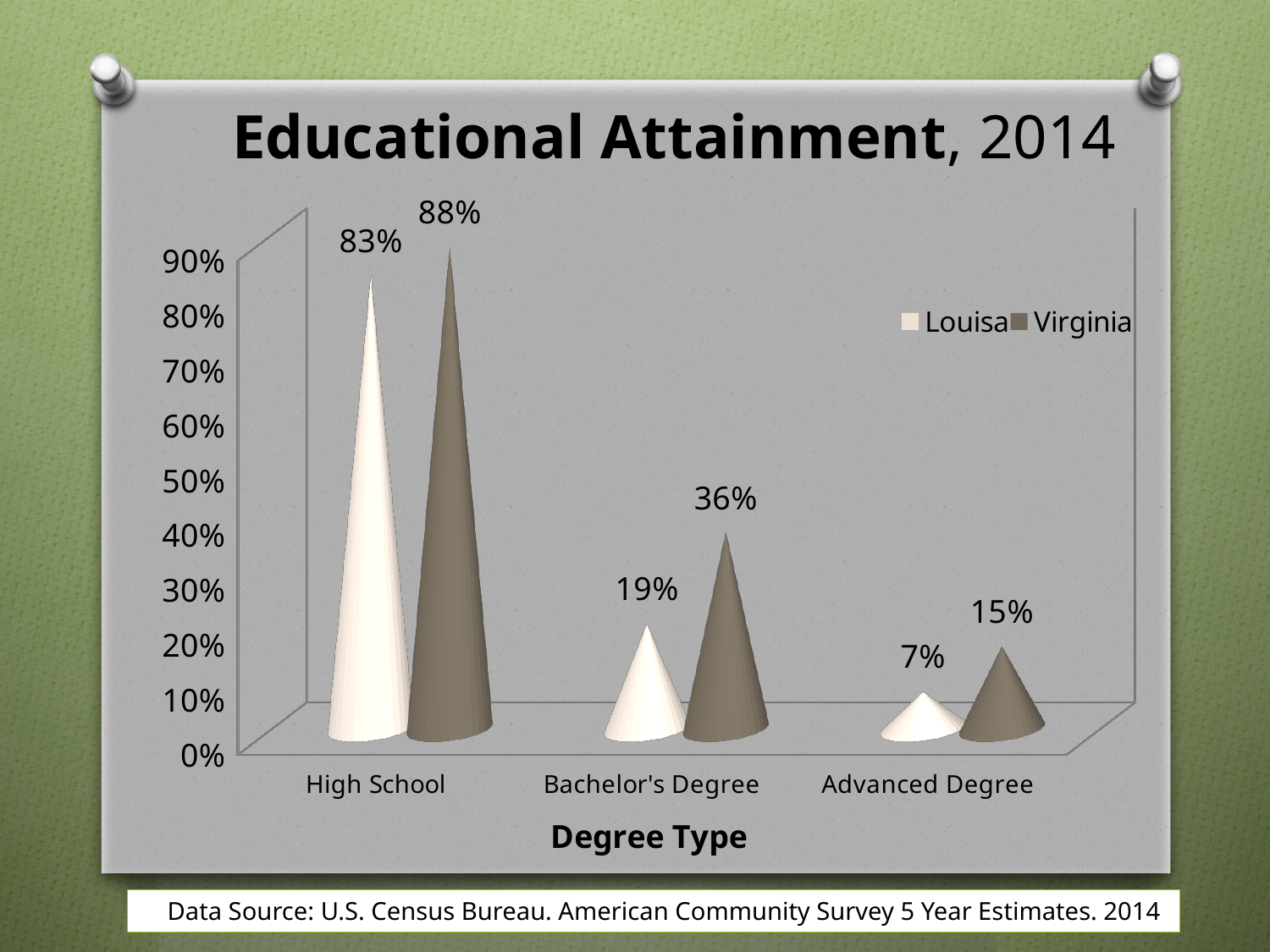
What is the value for Virginia for Bachelor's Degree? 36% Which degree type has the highest value for Virginia? High School Do the values for Louisa rise or fall from High School to Advanced Degree? Fall What is the title of the x axis? Degree Type How many degree types are shown on the x axis? 3 What kind of chart is shown on the slide? Bar chart Which is larger for Advanced Degree, Louisa or Virginia? Virginia How many series does the legend list? 2 What is the value for Louisa for Advanced Degree? 7% What is the value for Louisa for High School? 83% Which degree type has the lowest value for Louisa? Advanced Degree What is the difference between Virginia and Louisa for Bachelor's Degree? 17%